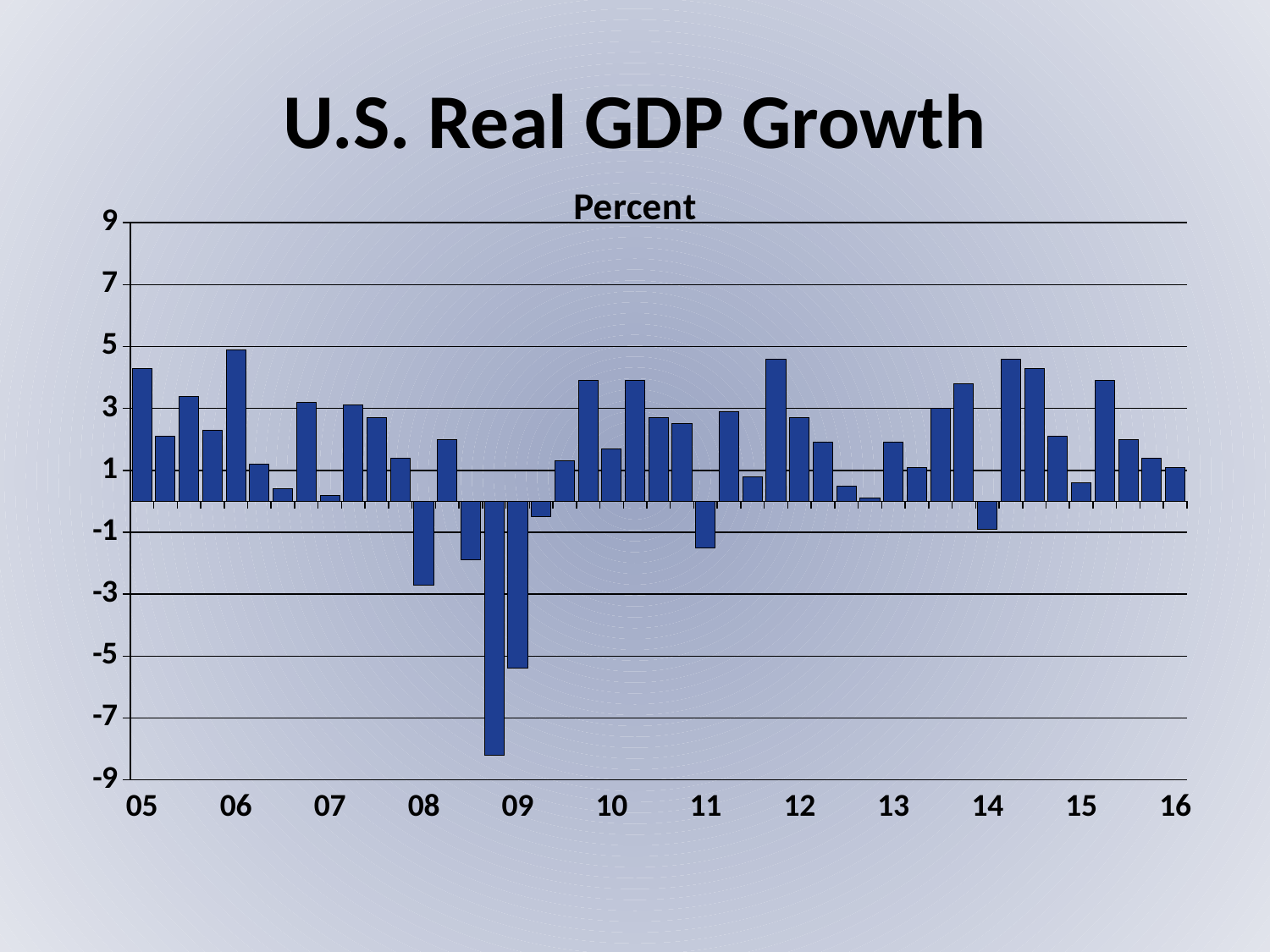
What unit label is shown above the chart's vertical axis? Percent Which is taller, the first bar in 05 or the first bar in 07? 05 Is the value of the lowest bar in 08 greater or less than -1? less What is the title of the chart? U.S. Real GDP Growth Is the value of the first bar in 05 greater or less than 5? less What kind of chart is shown on the slide? bar chart How many year labels are shown along the x axis? 12 Is the value of the tallest bar in 06 greater or less than 3? greater